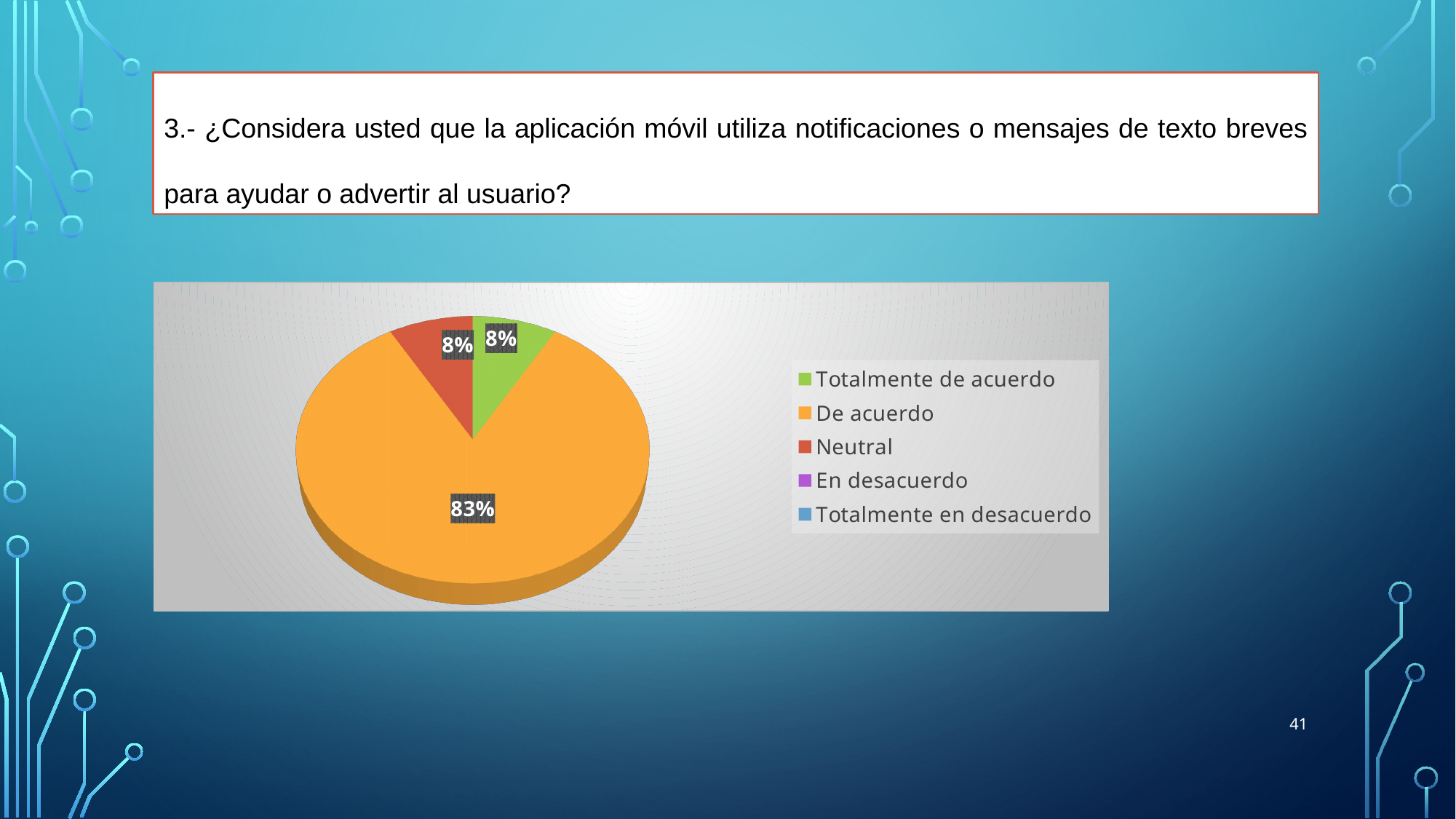
What colour is the slice for "De acuerdo"? orange Is the share for "De acuerdo" greater or less than 50%? greater What share of the pie does "De acuerdo" represent? 83% Which legend entry is shown in green? Totalmente de acuerdo What is the difference between the share for "De acuerdo" and the share for "Neutral"? 75% What share of the pie does "Totalmente de acuerdo" represent? 8% Which is larger, the slice for "De acuerdo" or the slice for "Neutral"? De acuerdo How many entries does the legend list? 5 How many slices with a printed percentage are visible in the pie? 3 What share of the pie does "Neutral" represent? 8% What kind of chart is shown on the slide? pie chart Which category has the largest slice of the pie? De acuerdo